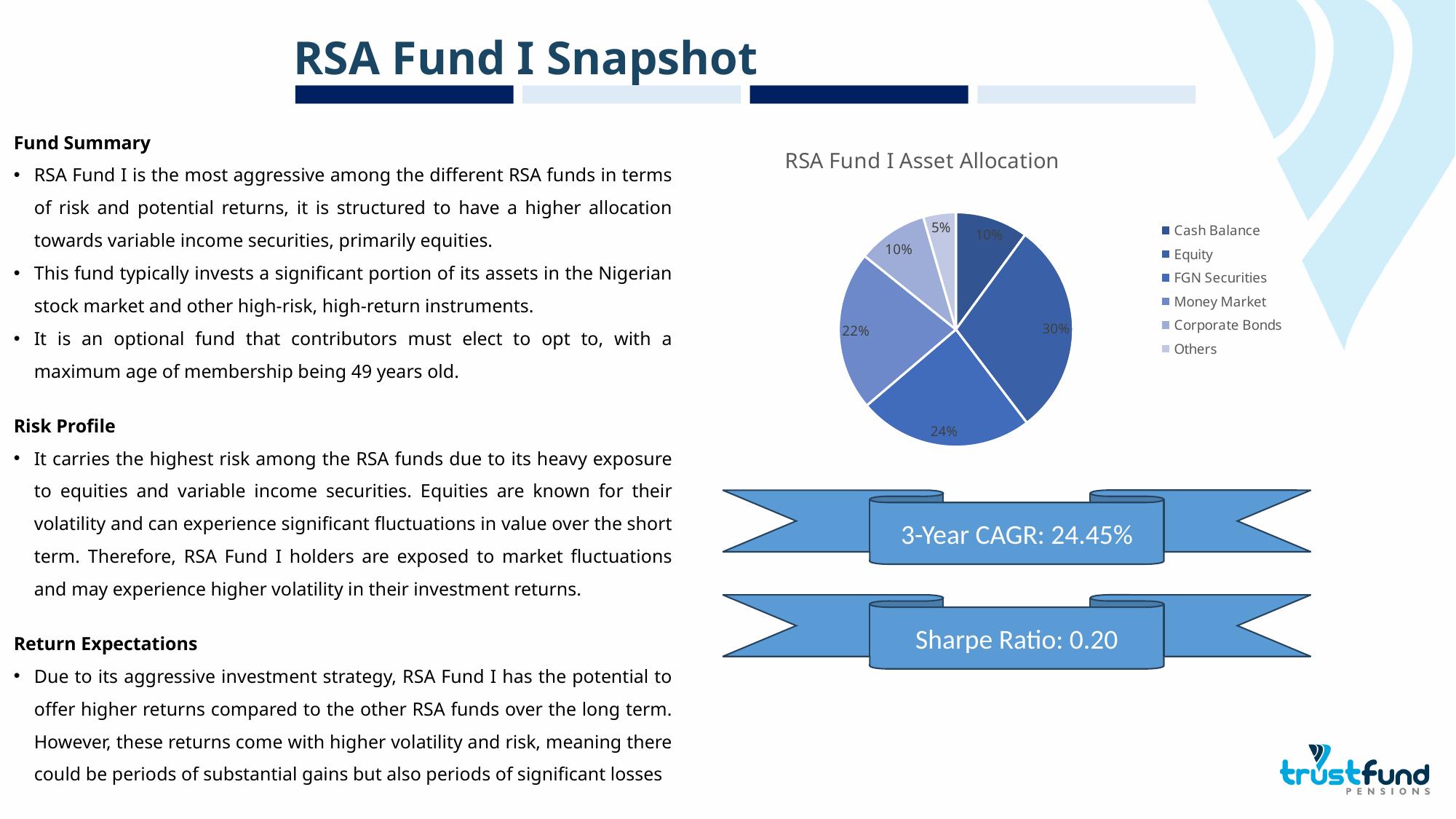
Which category has the smallest slice of the pie? Others What share of the pie does Equity represent? 30% What type of chart is shown on the slide? Pie chart What share of the pie does Others represent? 5% What is the combined share of the Cash Balance and Corporate Bonds slices? 20% What share of the pie does Money Market represent? 22% What is the difference in percentage points between the Equity slice and the FGN Securities slice? 6 How many categories does the legend of the pie chart list? 6 Which is larger, the Money Market slice or the Corporate Bonds slice? Money Market What is the title of the chart? RSA Fund I Asset Allocation Which category has the largest slice of the pie? Equity